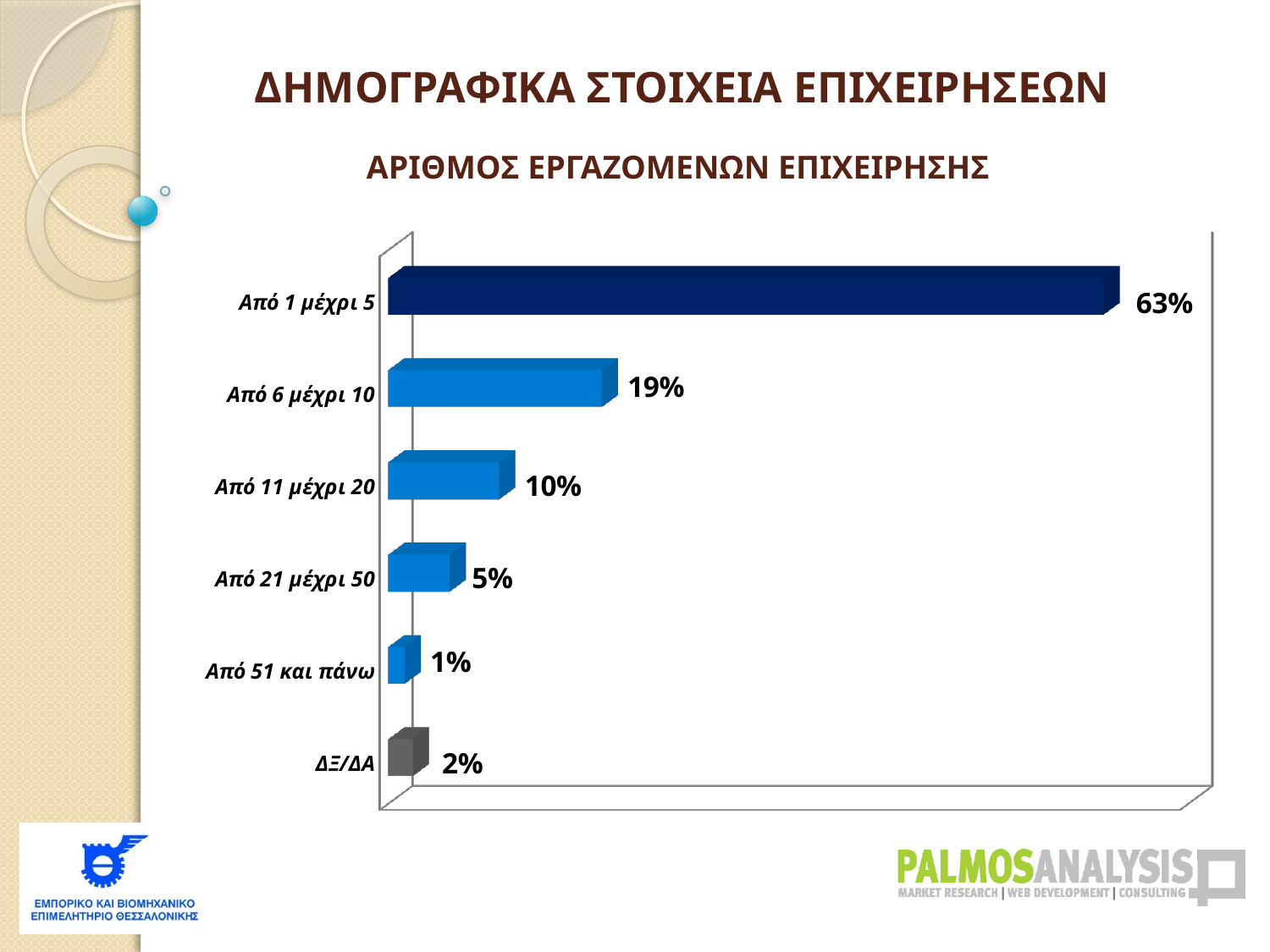
What percentage of businesses have from 1 to 5 employees (Από 1 μέχρι 5)? 63% Which category has the highest value? Από 1 μέχρι 5 What is the value shown for the category 'Από 6 μέχρι 10'? 19% How many categories are shown in the chart? 6 Which is larger, the value for 'Από 11 μέχρι 20' or the value for 'ΔΞ/ΔΑ'? Από 11 μέχρι 20 What is the difference between the values for 'Από 1 μέχρι 5' and 'Από 6 μέχρι 10'? 44% What is the value shown for the 'ΔΞ/ΔΑ' category? 2% Which category has the lowest value? Από 51 και πάνω What is the difference between the values for 'Από 11 μέχρι 20' and 'Από 21 μέχρι 50'? 5% What is the value shown for 'Από 21 μέχρι 50'? 5% What kind of chart is shown on the slide? Bar chart What is the title of the chart? ΑΡΙΘΜΟΣ ΕΡΓΑΖΟΜΕΝΩΝ ΕΠΙΧΕΙΡΗΣΗΣ